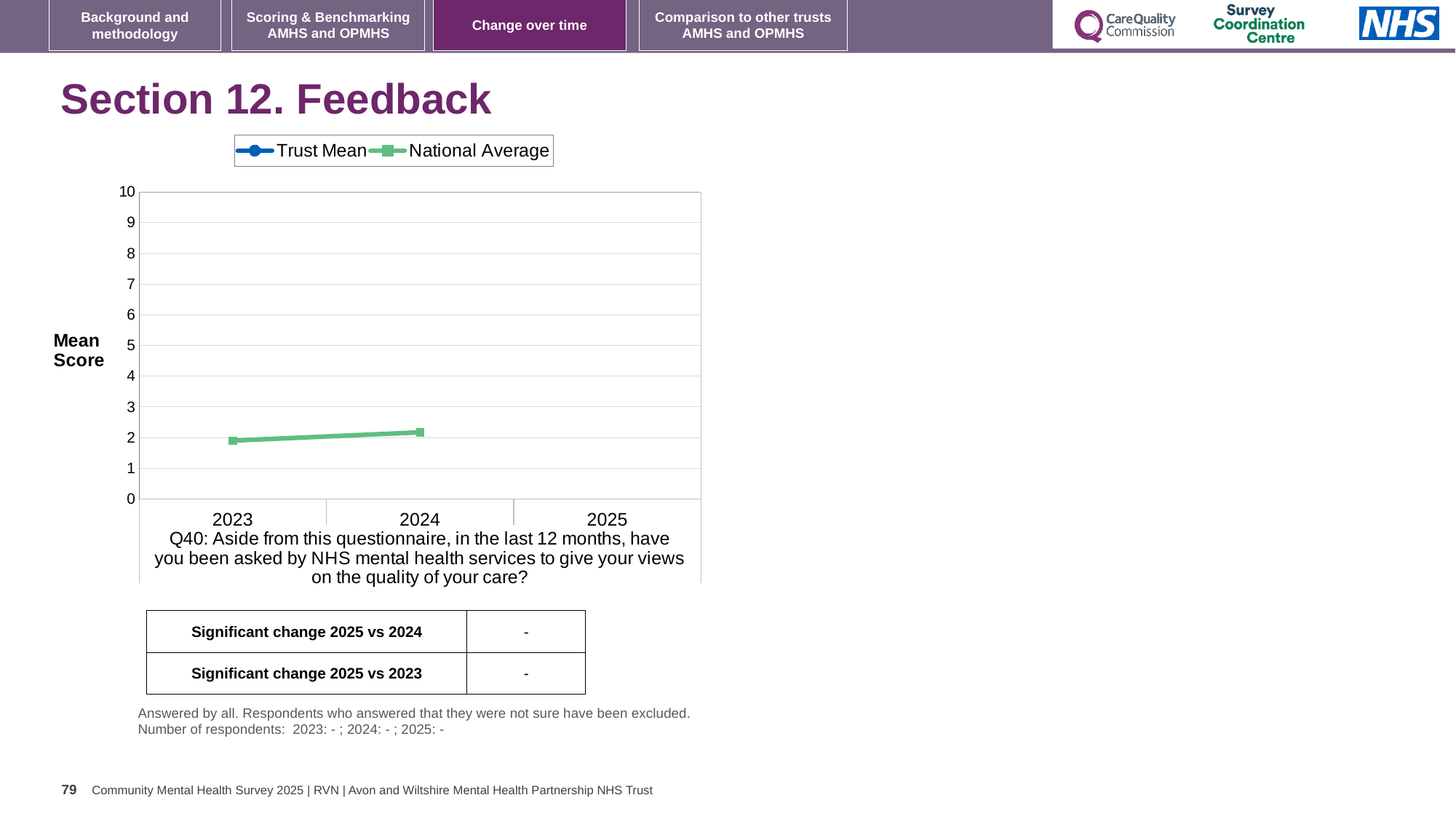
Which year has the higher National Average value, 2023 or 2024? 2024 What kind of chart is shown on the slide? line chart Does the National Average line rise or fall from 2023 to 2024? rise Is the National Average value for 2023 greater or less than 3? less How many years are shown on the x axis? 3 Is the National Average value for 2024 greater or less than 3? less What is the highest value shown on the y axis? 10 How many series does the legend list? 2 Which two series are listed in the legend? Trust Mean and National Average Is the National Average value for 2023 greater or less than 1? greater What is the label on the y axis? Mean Score